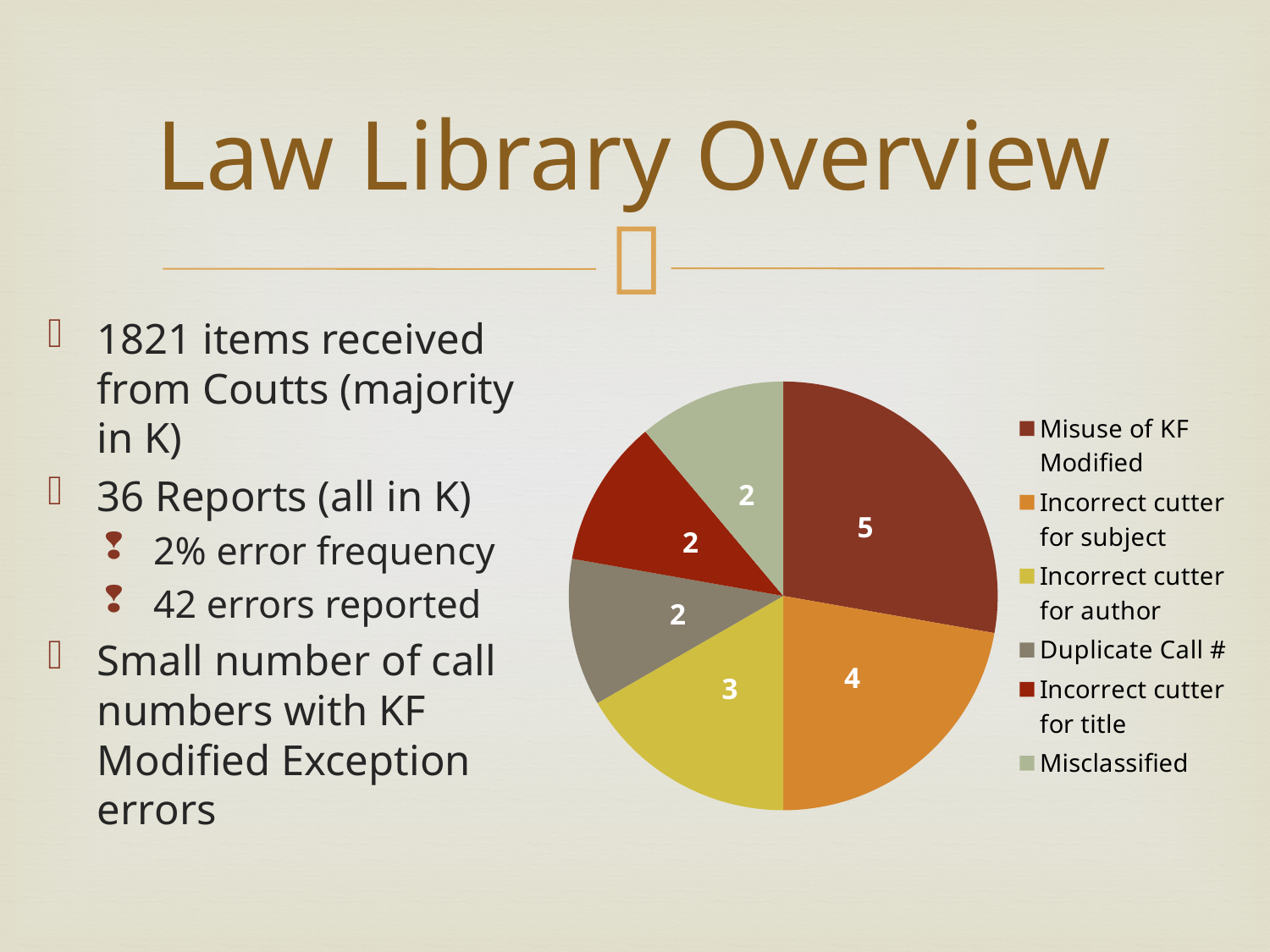
How many entries does the pie chart's legend list? 6 Which category has the largest slice in the pie chart? Misuse of KF Modified Which legend entry is shown in yellow in the pie chart? Incorrect cutter for author What is the difference between the values for Misuse of KF Modified and Incorrect cutter for author? 2 Which is larger in the pie chart: Incorrect cutter for subject or Misclassified? Incorrect cutter for subject What type of chart is shown on the slide? pie chart What is the value for Misuse of KF Modified in the pie chart? 5 What is the total of all the slice values in the pie chart? 18 What is the value for Duplicate Call # in the pie chart? 2 What is the value for Incorrect cutter for author in the pie chart? 3 How many slices does the pie chart have? 6 What is the value for Incorrect cutter for subject in the pie chart? 4